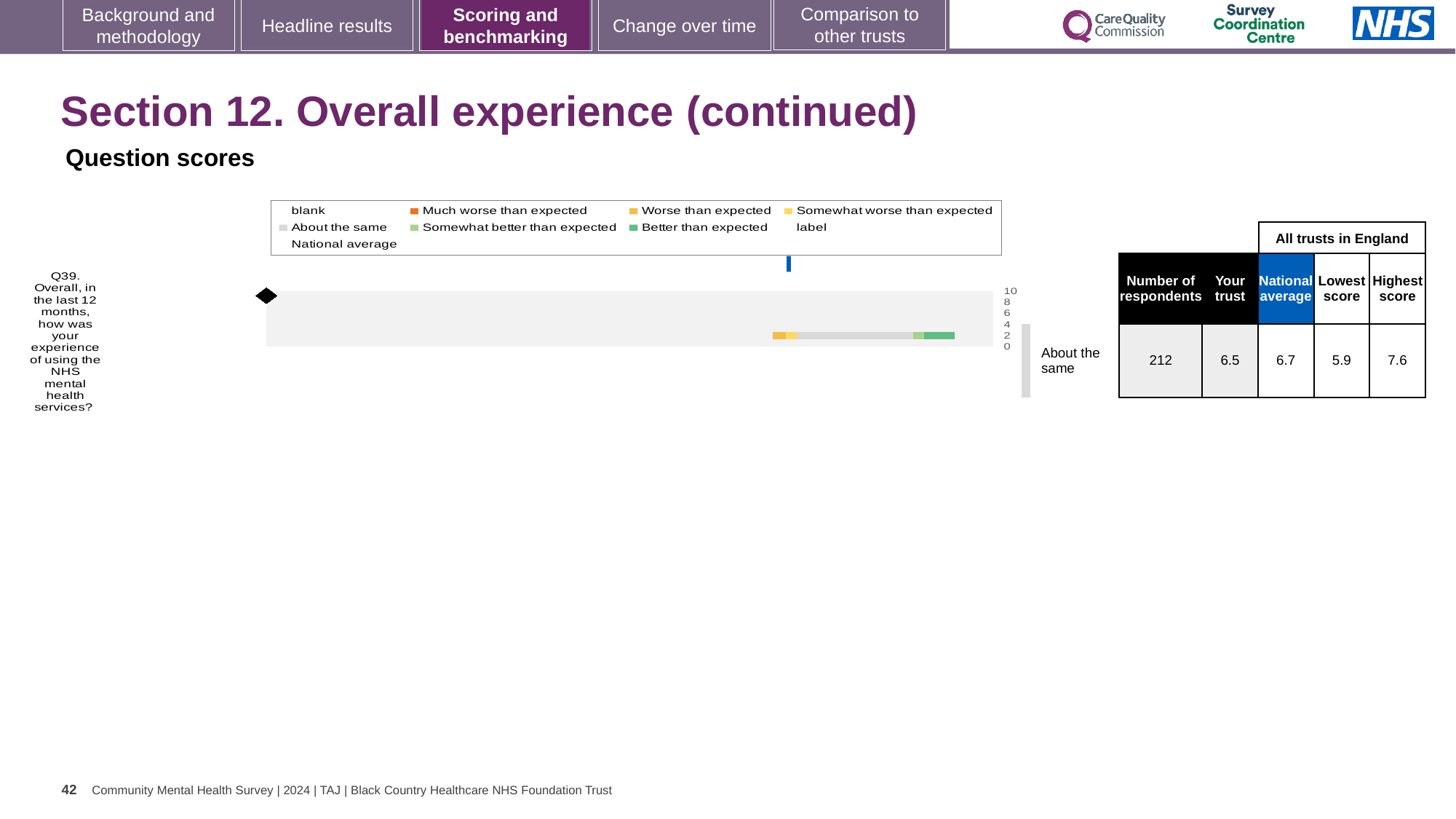
What is the national average score for Q39? 6.7 What is the difference between the highest and lowest trust scores for Q39? 1.7 What benchmark category is the trust's Q39 score placed in? About the same Which legend entry is shown in orange? Much worse than expected What is the highest score among all trusts in England for Q39? 7.6 Which is larger for Q39, the 'Your trust' score or the national average? National average What is the 'Your trust' score for Q39? 6.5 What kind of chart is used to show the Q39 question score? bar chart How many respondents answered Q39? 212 How many survey questions are plotted on the chart? 1 What is the lowest score among all trusts in England for Q39? 5.9 What is the difference between the national average and the 'Your trust' score for Q39? 0.2